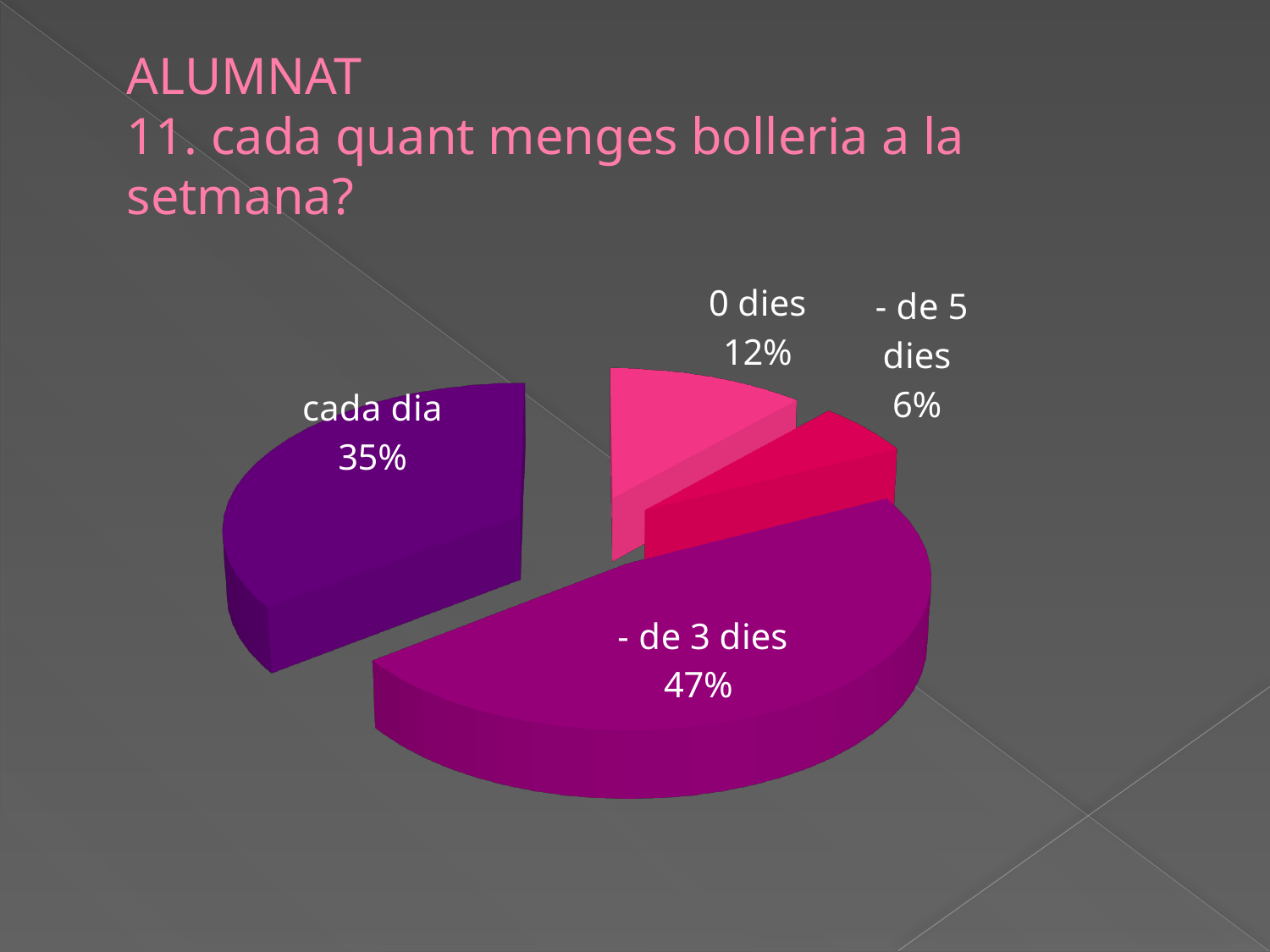
Which is larger, the share for "0 dies" or the share for "- de 5 dies"? 0 dies What percentage of students answered "- de 5 dies"? 6% What percentage of students answered "cada dia"? 35% What percentage of students answered "0 dies"? 12% Which category has the smallest share of the pie? - de 5 dies What percentage of students answered "- de 3 dies"? 47% How many categories are shown in the pie chart? 4 Which category has the largest share of the pie? - de 3 dies What is the difference in percentage points between "0 dies" and "- de 5 dies"? 6 What kind of chart is shown on the slide? pie chart What is the difference in percentage points between "- de 3 dies" and "cada dia"? 12 What is the title of the chart on the slide? ALUMNAT 11. cada quant menges bolleria a la setmana?